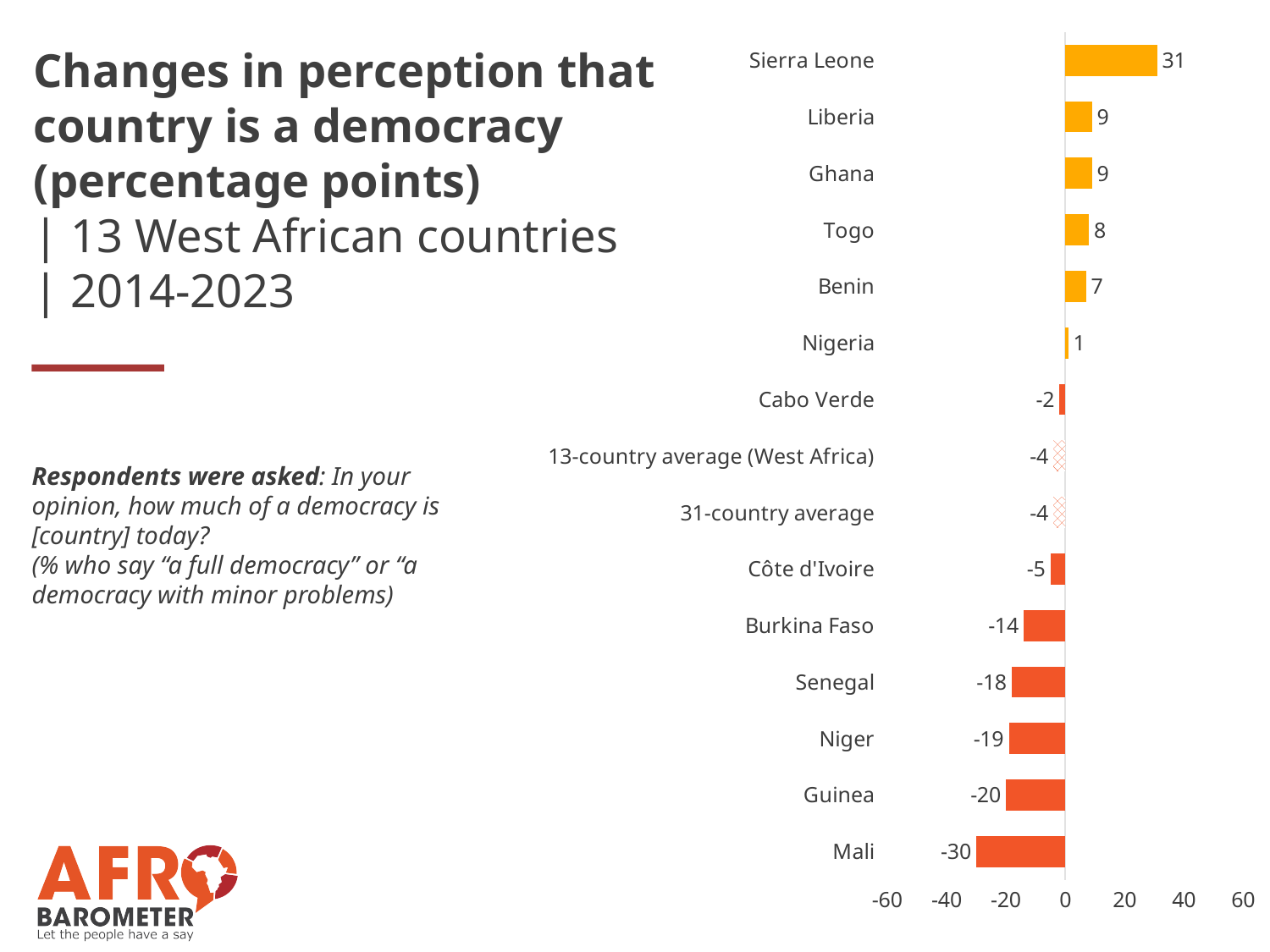
What is the value for the 13-country average (West Africa)? -4 What is the difference between the values for Sierra Leone and Liberia? 22 Which has a larger value, Senegal or Niger? Senegal How many bars are plotted in the chart? 15 What is the value for Mali? -30 What is the value for Sierra Leone? 31 Which country has the highest value? Sierra Leone What is the difference between the values for Guinea and Mali? 10 Which country has the lowest value? Mali What kind of chart is shown on the slide? Bar chart What is the value for Togo? 8 What is the value for Burkina Faso? -14